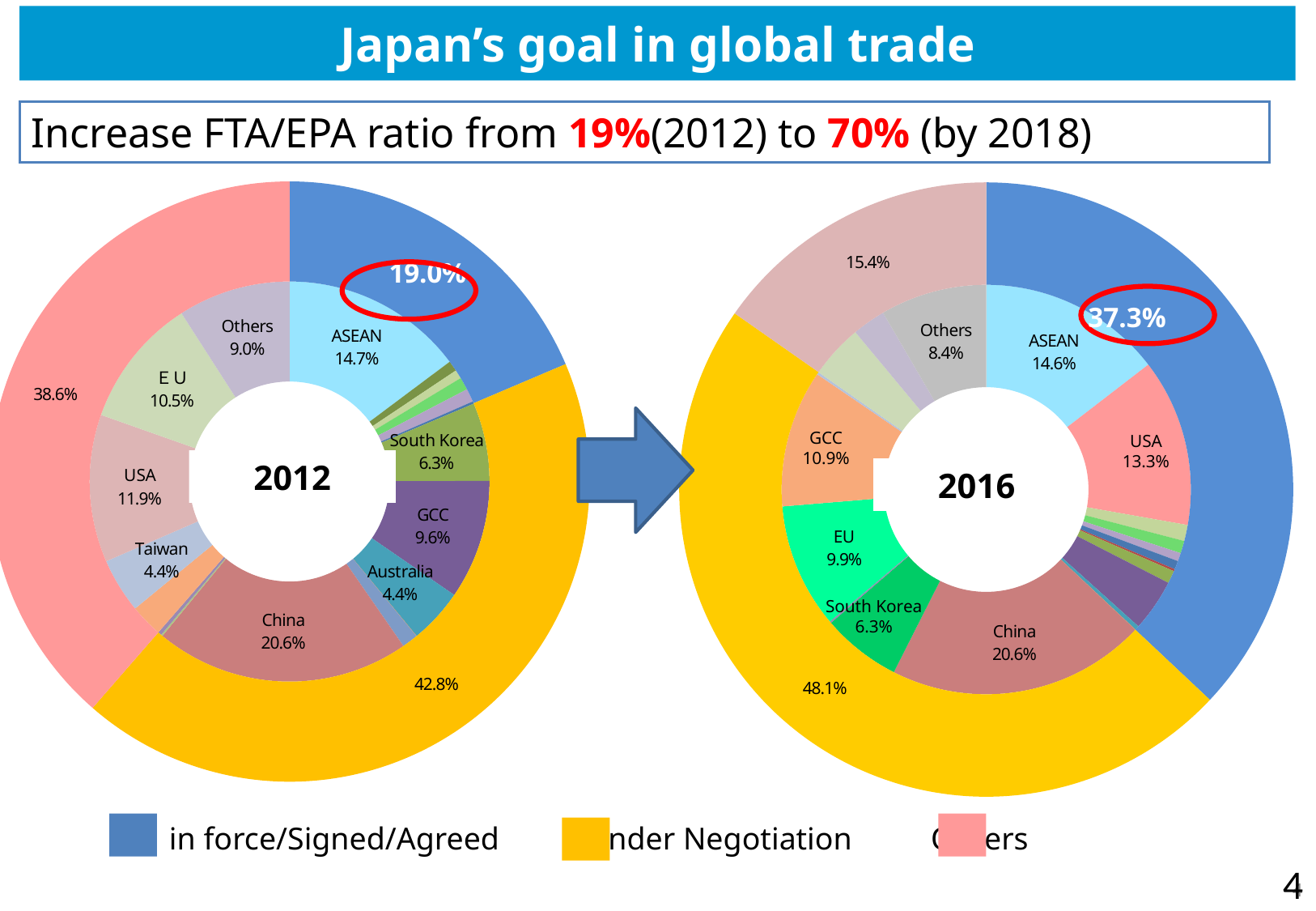
How many categories does the legend at the bottom of the slide list? 3 In the 2012 chart, which labelled country or region in the inner ring has the largest share? China In the 2016 chart, what is the share labelled for the 'Others' segment of the outer ring? 15.4% In the 2016 chart, what share of the outer ring is labelled for the 'in force/Signed/Agreed' segment? 37.3% In the 2012 chart, what is the share for China in the inner ring? 20.6% In the 2016 chart, which is larger in the inner ring, USA or ASEAN? ASEAN In the 2012 chart, what is the share labelled for the 'Under Negotiation' segment of the outer ring? 42.8% In the 2012 chart, what is the difference between the USA share (11.9%) and the EU share (10.5%) in the inner ring? 1.4% What kind of chart is used to show the 2012 and 2016 data? Doughnut (pie) chart In the 2016 chart, what is the share for GCC in the inner ring? 10.9% In the 2012 chart, what share of the outer ring is labelled for the 'in force/Signed/Agreed' segment? 19.0% What is the difference between the 'in force/Signed/Agreed' share in the 2016 chart (37.3%) and in the 2012 chart (19.0%)? 18.3%